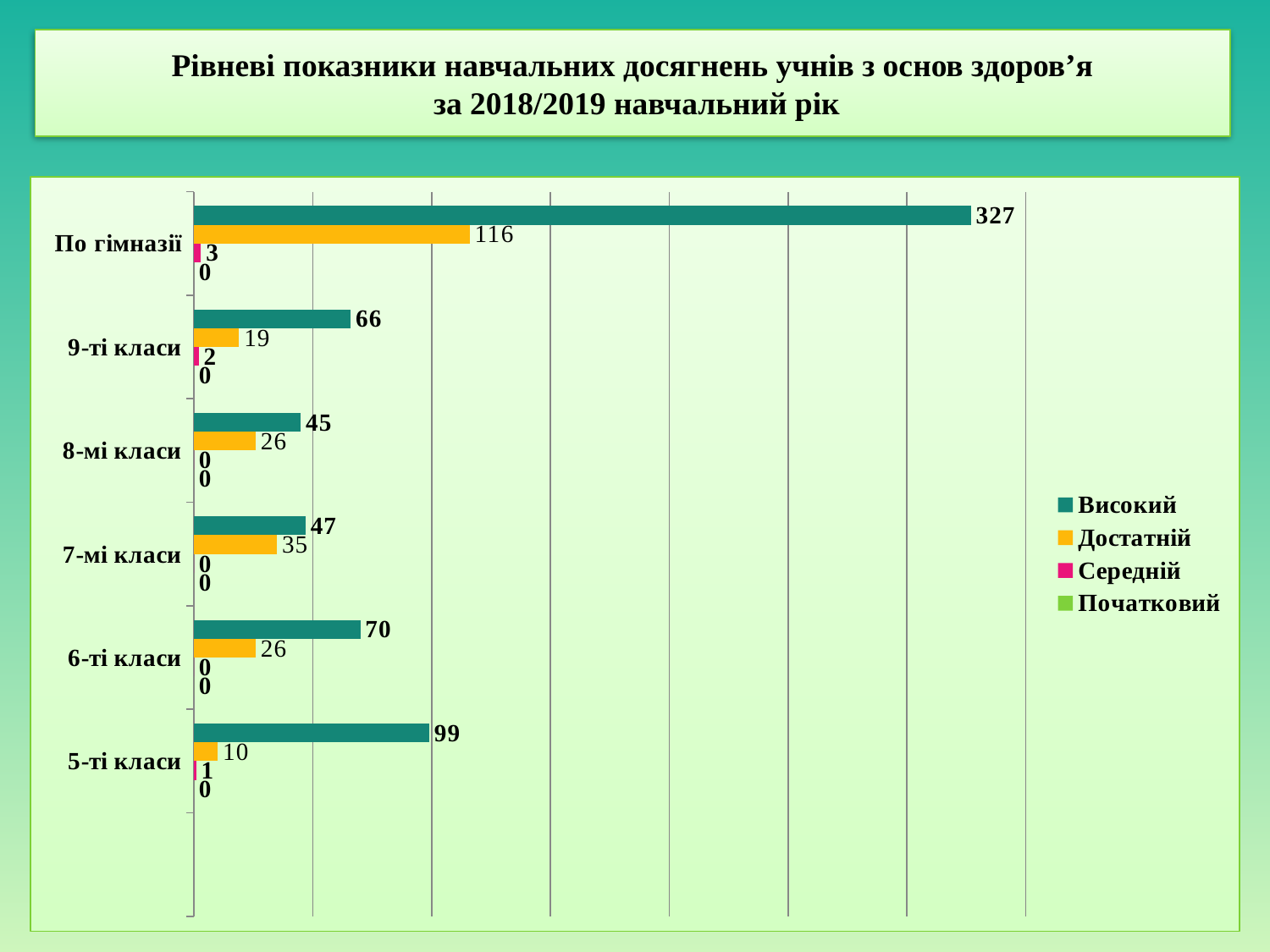
What is the value of Початковий for По гімназії? 0 What is the value of Високий for 5-ті класи? 99 What kind of chart is shown on the slide? Bar chart What is the value of Середній for 9-ті класи? 2 Among the class groups (excluding По гімназії), which category has the lowest Достатній value? 5-ті класи Which is larger, the Достатній value for 8-мі класи or for 9-ті класи? 8-мі класи What is the value of Достатній for По гімназії? 116 Among the class groups (excluding По гімназії), which category has the highest Високий value? 5-ті класи How many categories are shown on the chart? 6 What is the value of Достатній for 7-мі класи? 35 How many series does the legend list? 4 What is the difference between the Високий values for 6-ті класи and 9-ті класи? 4